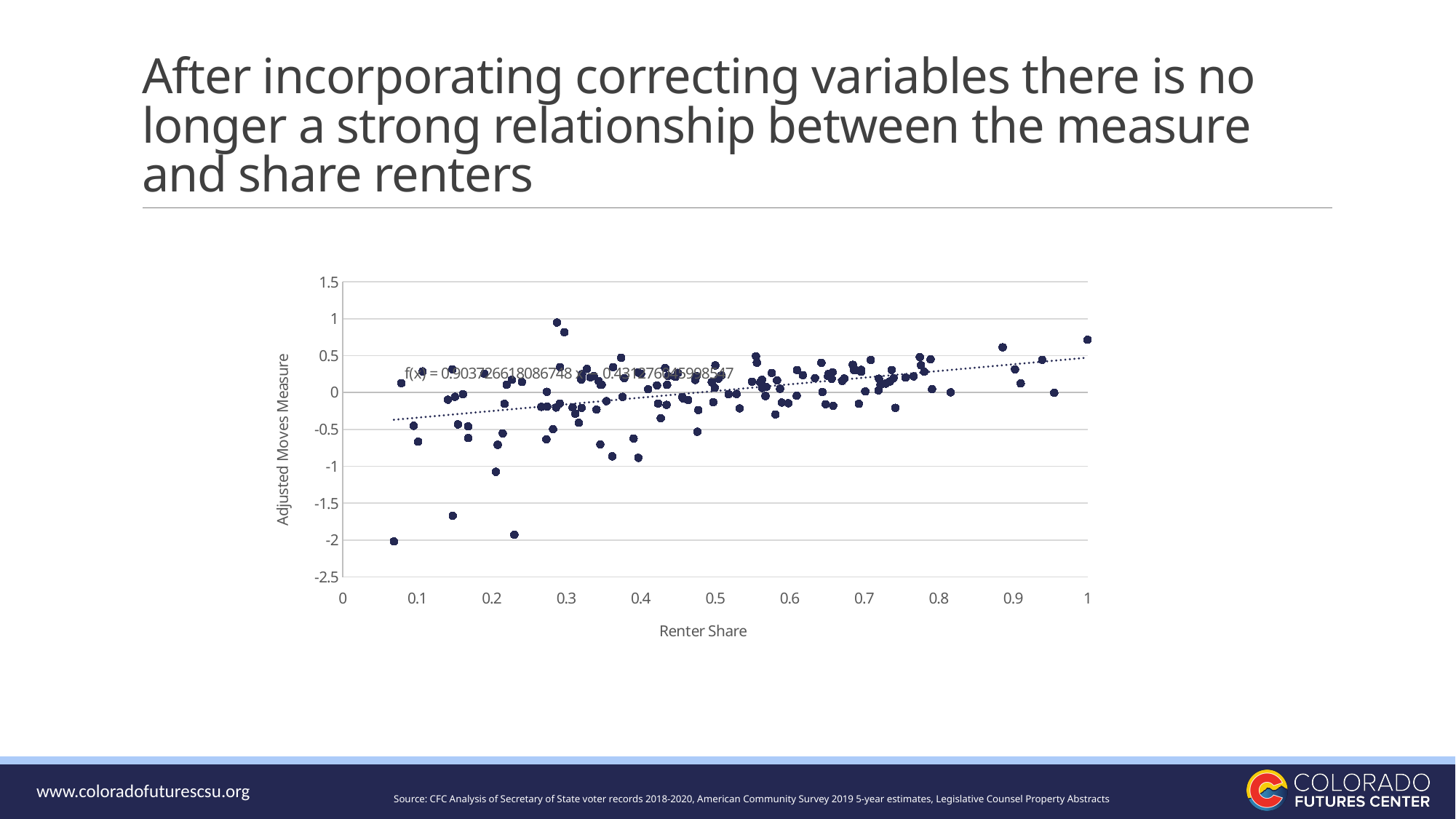
Is the Renter Share of the highest point in the chart greater or less than 0.5? less Is the highest point in the chart greater or less than 0.5 on the Adjusted Moves Measure axis? greater Does the dotted trendline in the chart rise or fall as Renter Share increases? Rises What is the label of the y axis of the chart? Adjusted Moves Measure Is the lowest point in the chart greater or less than -1.5 on the Adjusted Moves Measure axis? less What is the lowest value shown on the y axis of the chart? -2.5 What is the label of the x axis of the chart? Renter Share What kind of chart is shown on the slide? Scatter plot